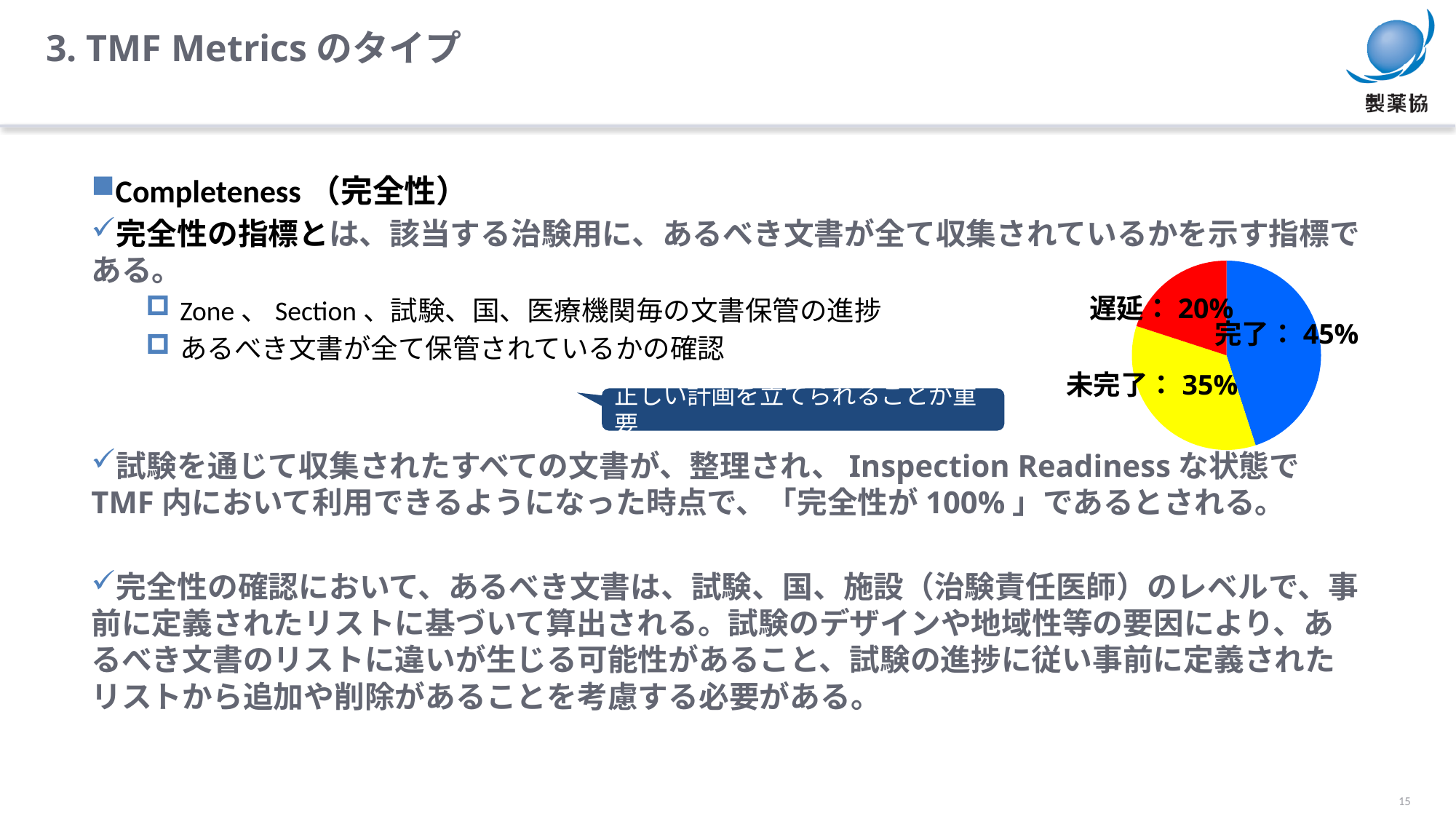
What kind of chart is shown on the slide? pie chart What is the value for 未完了 in the pie chart? 35% What is the difference between the values for 完了 and 未完了 in the pie chart? 10% What is the value for 完了 in the pie chart? 45% What is the difference between the values for 未完了 and 遅延 in the pie chart? 15% Which category has the smallest slice in the pie chart? 遅延 Which category has the largest slice in the pie chart? 完了 What colour is the 遅延 slice in the pie chart? red Which is larger in the pie chart, 未完了 or 遅延? 未完了 What is the value for 遅延 in the pie chart? 20% What colour is the 完了 slice in the pie chart? blue How many slices does the pie chart have? 3